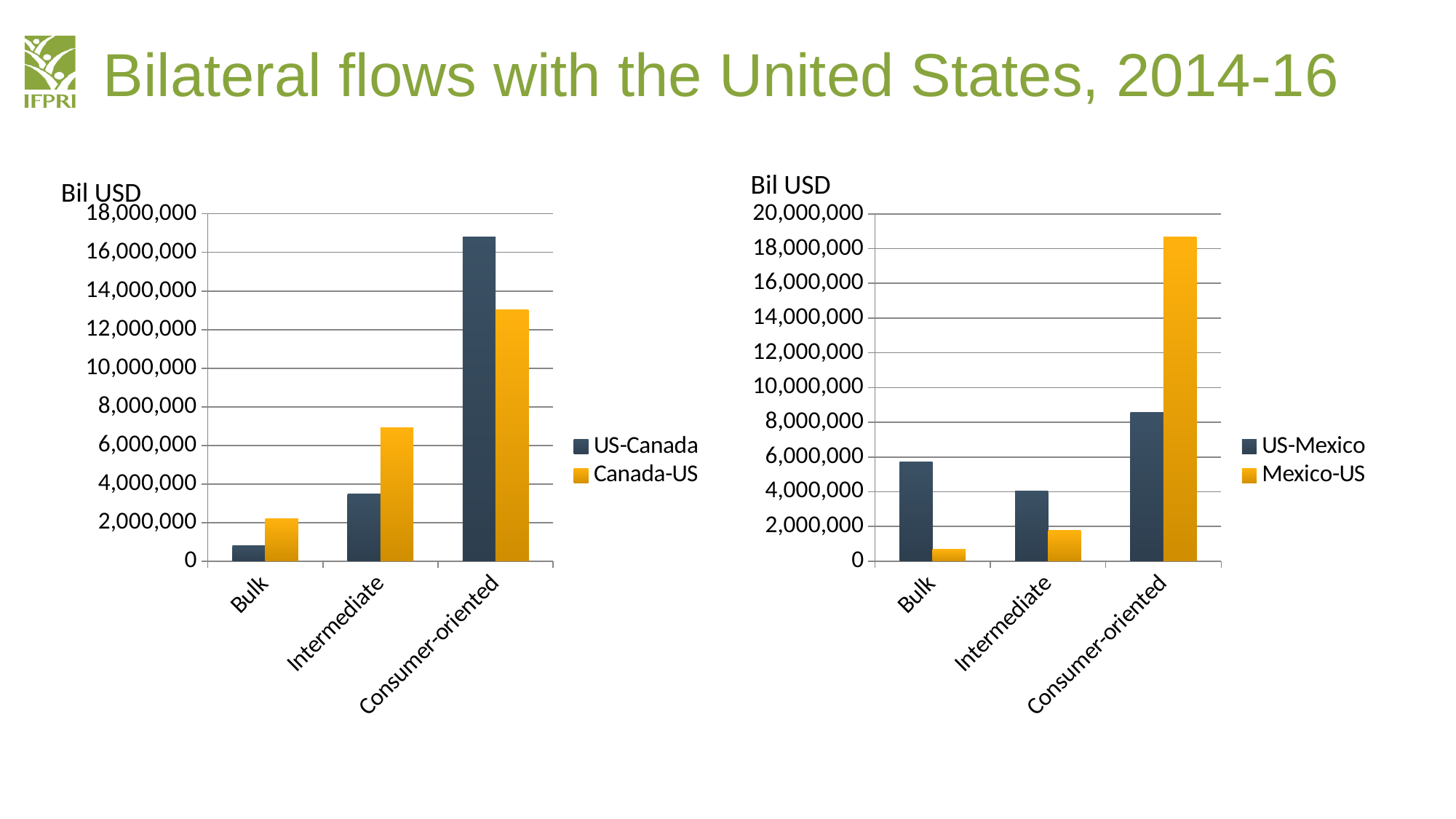
In the right chart, is the Mexico-US value for Consumer-oriented greater or less than 18,000,000? greater In the left chart, do the US-Canada values rise or fall from Bulk to Consumer-oriented? rise How many categories are shown on the x axis of the left chart? 3 In the right chart, which category has the highest Mexico-US value? Consumer-oriented In the left chart, which is larger for Intermediate: US-Canada or Canada-US? Canada-US In the left chart, which category has the highest US-Canada value? Consumer-oriented In the right chart, which is larger for Bulk: US-Mexico or Mexico-US? US-Mexico In the left chart, which category has the lowest Canada-US value? Bulk How many series does the legend of the right chart list? 2 What kind of chart is the left chart on the slide? bar chart In the left chart, is the US-Canada value for Consumer-oriented greater or less than 16,000,000? greater In the right chart, which category has the lowest Mexico-US value? Bulk